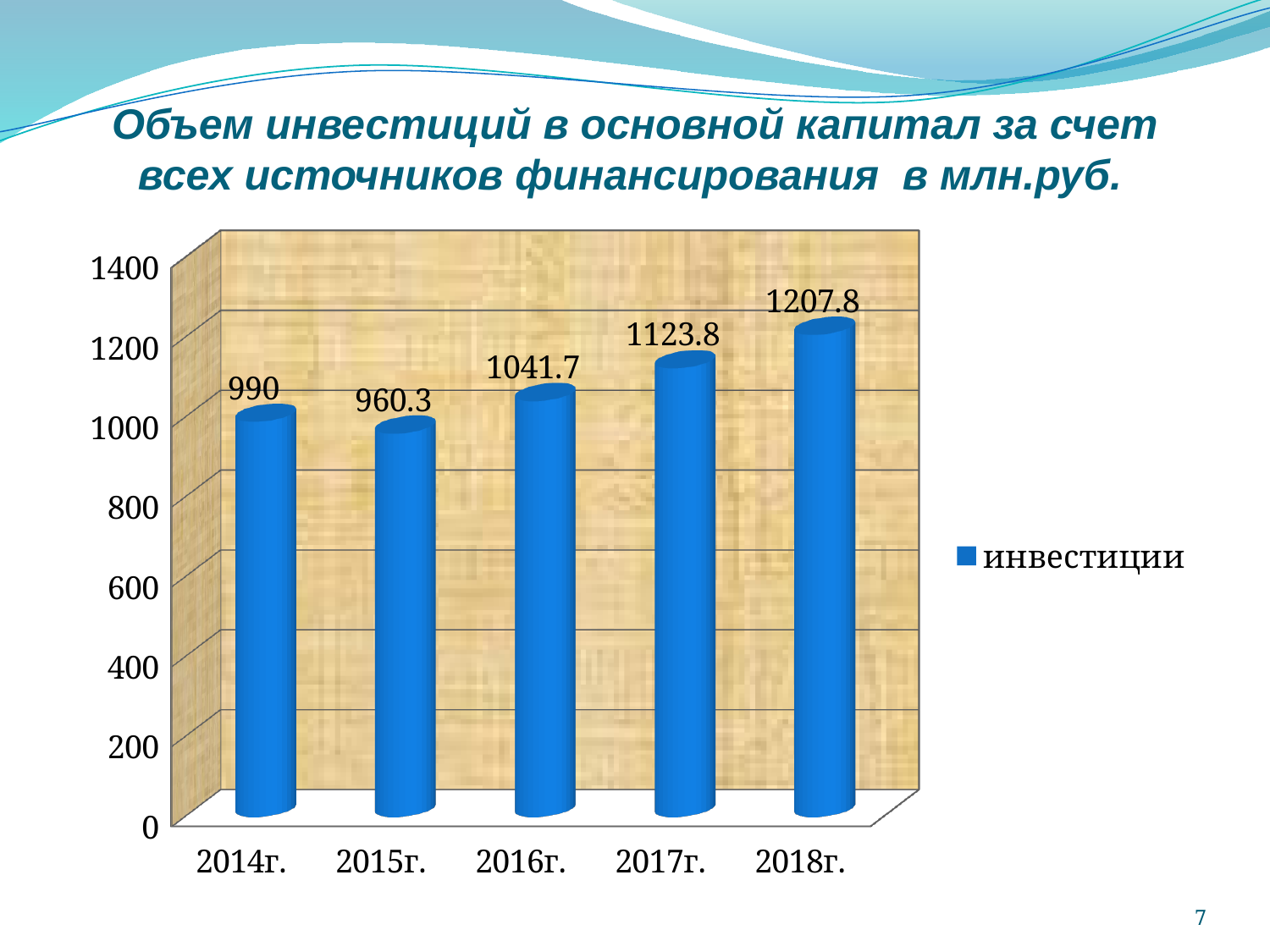
Which year has the highest value? 2018г. What is the value for 2014г.? 990 How many series does the legend list? 1 Which year has the lowest value? 2015г. What is the difference between the values for 2018г. and 2017г.? 84 What is the value for 2016г.? 1041.7 What kind of chart is this? bar chart What is the legend entry for the series? инвестиции How many years are shown on the x axis? 5 What is the difference between the values for 2014г. and 2015г.? 29.7 Which is larger, the value for 2016г. or the value for 2017г.? 2017г. What is the value for 2018г.? 1207.8